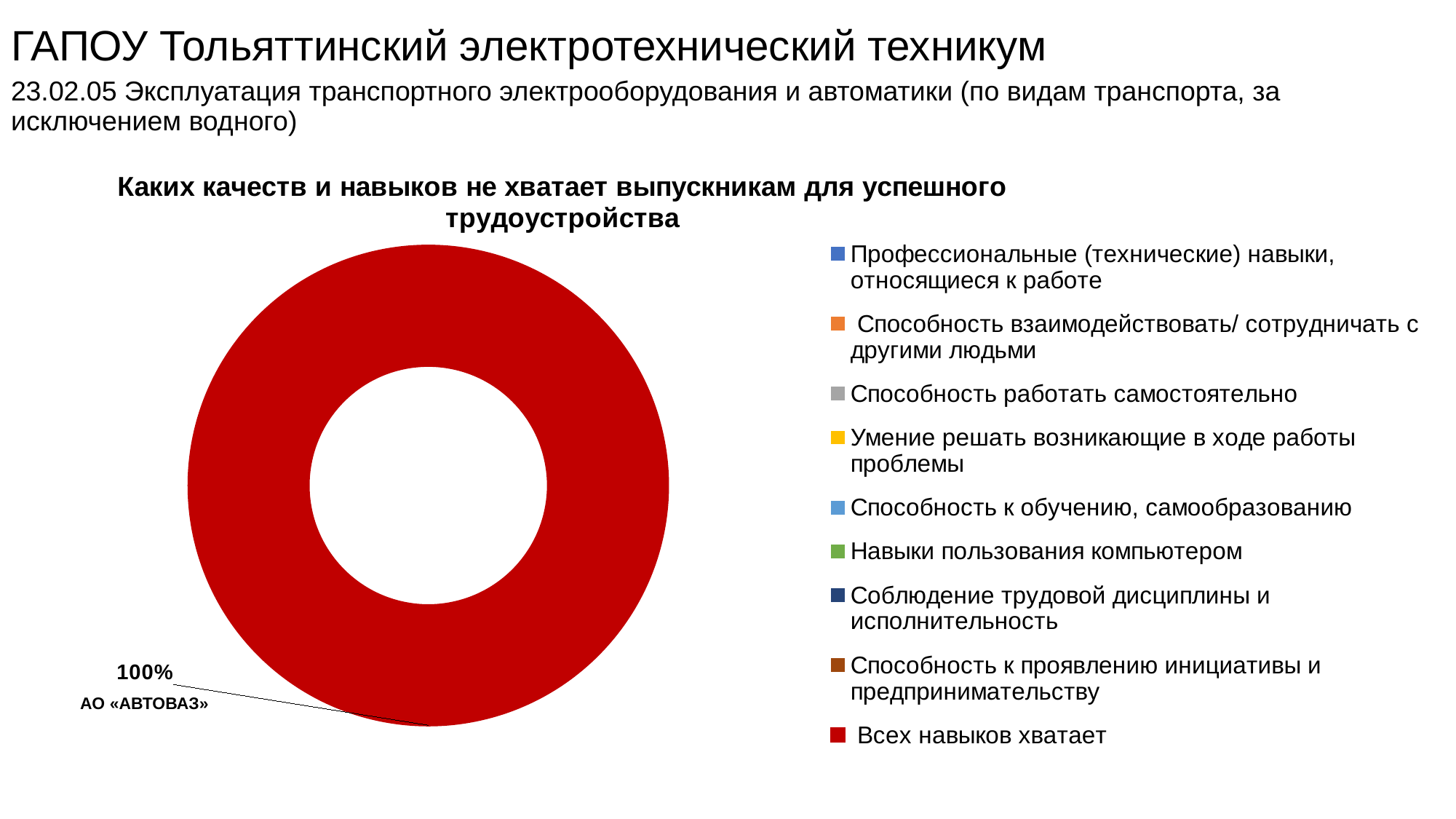
What is the title of the chart? Каких качеств и навыков не хватает выпускникам для успешного трудоустройства What share of the chart does the category 'Всех навыков хватает' take? 100% Is the share for 'Всех навыков хватает' greater or less than 50%? greater How many slices are visible in the chart? 1 How many entries does the legend list? 9 Which category accounts for the largest share of the chart? Всех навыков хватает Which organisation is named in the data label next to the 100% value? АО «АВТОВАЗ» What kind of chart is shown on the slide? doughnut chart What colour is the slice that fills the entire chart? red What percentage is shown on the data label of the chart? 100%